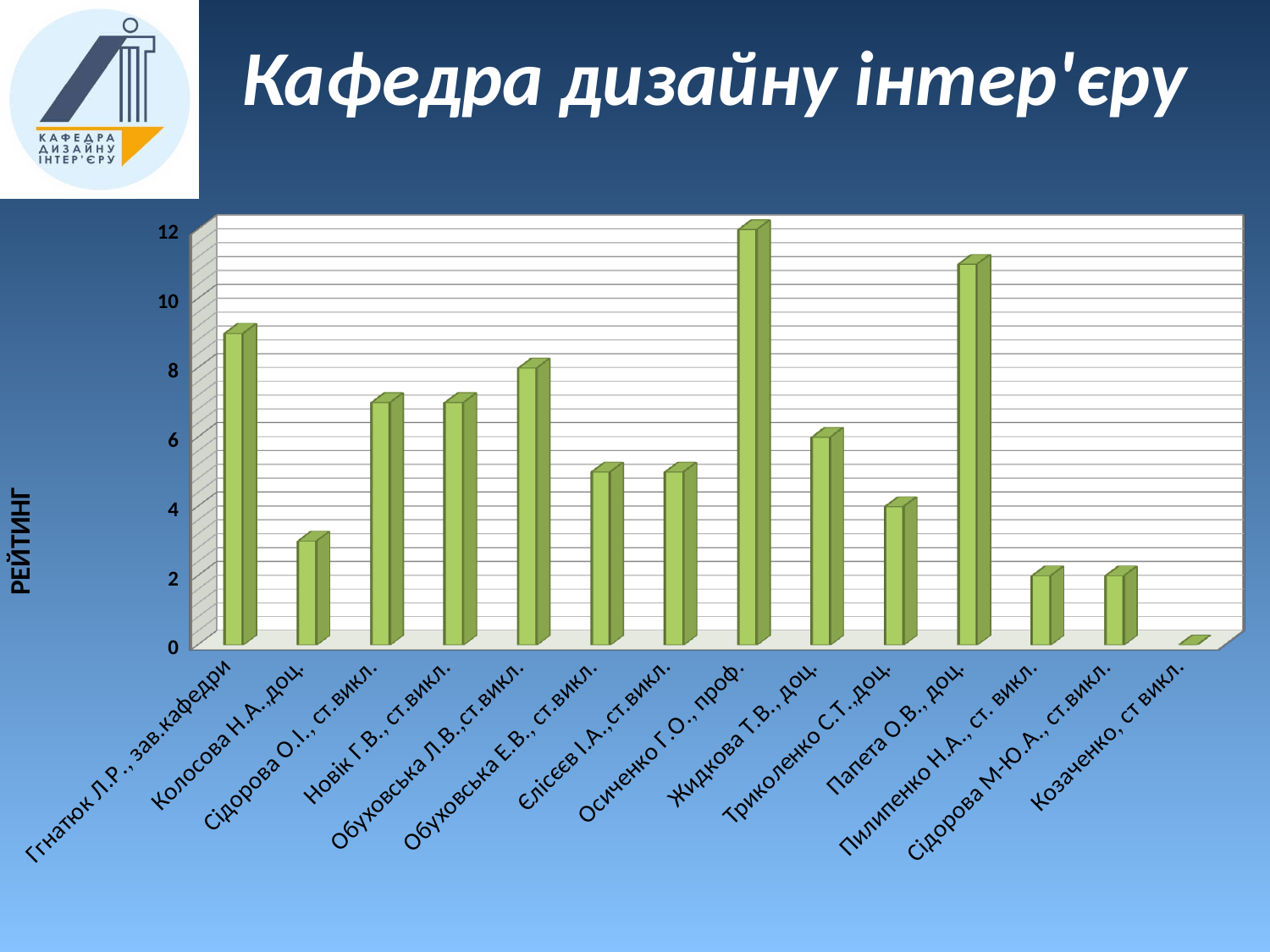
Which has the larger value: Осиченко Г.О., проф. or Пилипенко Н.А., ст. викл.? Осиченко Г.О., проф. Which category has the highest value in the chart? Осиченко Г.О., проф. What is the label of the vertical axis of the chart? РЕЙТИНГ Which category has the lowest value in the chart? Козаченко, ст викл. Is the value for Папета О.В., доц. greater or less than 10? greater How many categories (people) are shown on the x axis of the chart? 14 Is the value for Триколенко С.Т.,доц. greater or less than 6? less Which has the larger value: Гнатюк Л.Р., зав.кафедри or Колосова Н.А.,доц.? Гнатюк Л.Р., зав.кафедри Is the value for Колосова Н.А.,доц. greater or less than 4? less What kind of chart is shown on the slide? bar chart